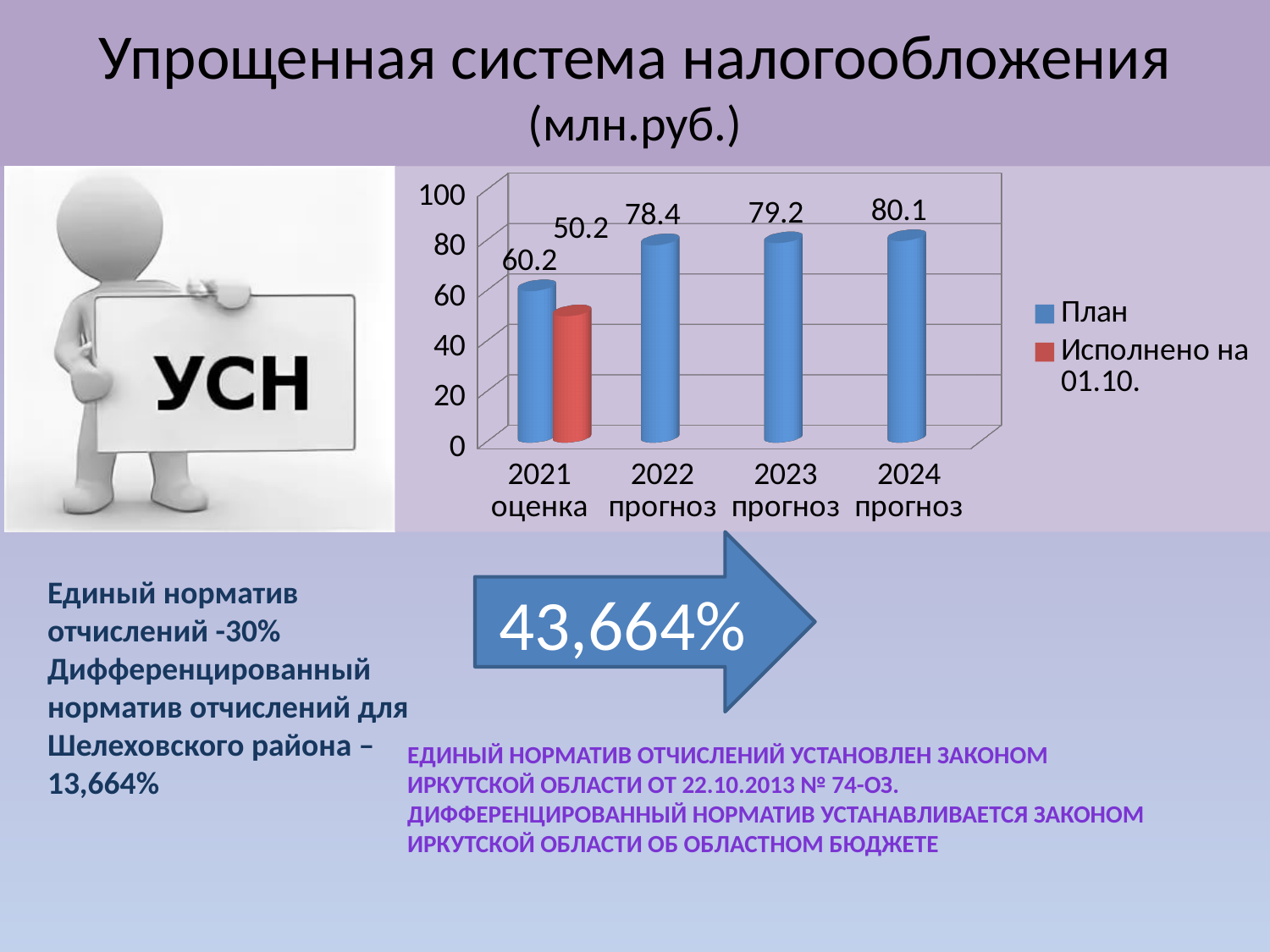
Which is larger: the План value for 2023 прогноз or the План value for 2021 оценка? 2023 прогноз What is the План value for 2024 прогноз? 80.1 What is the difference between the План and Исполнено на 01.10. values for 2021 оценка? 10 What is the План value for 2021 оценка? 60.2 How many series does the chart legend list? 2 Do the План values rise or fall from 2021 оценка to 2024 прогноз? rise How many categories are shown on the x axis of the chart? 4 What is the Исполнено на 01.10. value for 2021 оценка? 50.2 Which category has the highest План value? 2024 прогноз What is the План value for 2022 прогноз? 78.4 Which category has the lowest План value? 2021 оценка What kind of chart is shown on the slide? bar chart